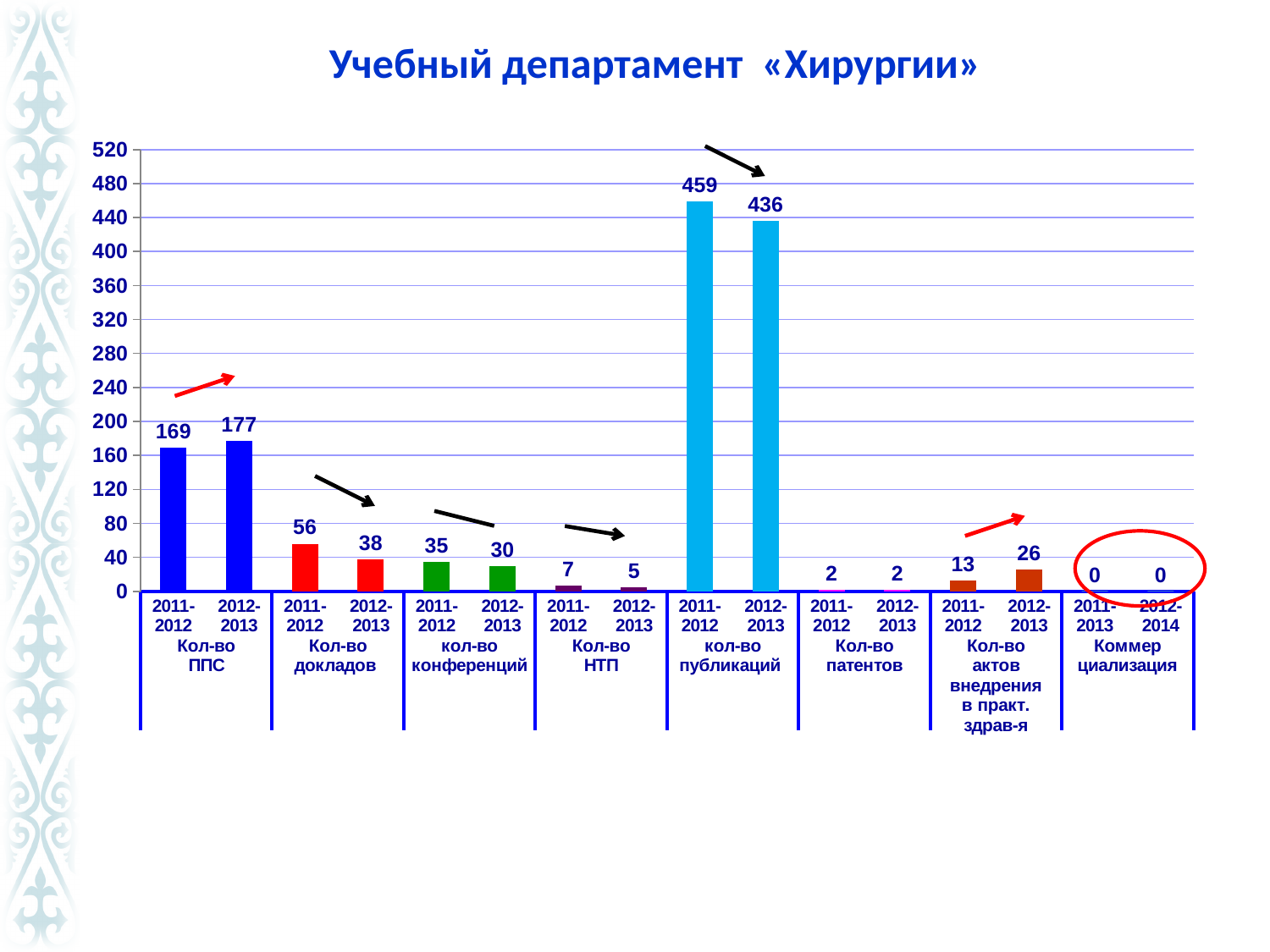
What is the value for Кол-во докладов in 2012-2013? 38 How many categories (groups) are shown along the x axis? 8 What is the value for Кол-во ППС in 2011-2012? 169 What is the value for Кол-во актов внедрения в практ. здрав-я in 2012-2013? 26 What is the value for кол-во публикаций in 2012-2013? 436 What is the difference between the 2012-2013 and 2011-2012 values for Кол-во ППС? 8 What is the title of the slide? Учебный департамент «Хирургии» What kind of chart is shown on the slide? bar chart What is the difference between the 2011-2012 and 2012-2013 values for кол-во публикаций? 23 Is the value for Кол-во ППС in 2012-2013 greater or less than 160? greater Which is larger for Кол-во докладов: the 2011-2012 value or the 2012-2013 value? 2011-2012 Which bar has the highest value on the chart? кол-во публикаций, 2011-2012